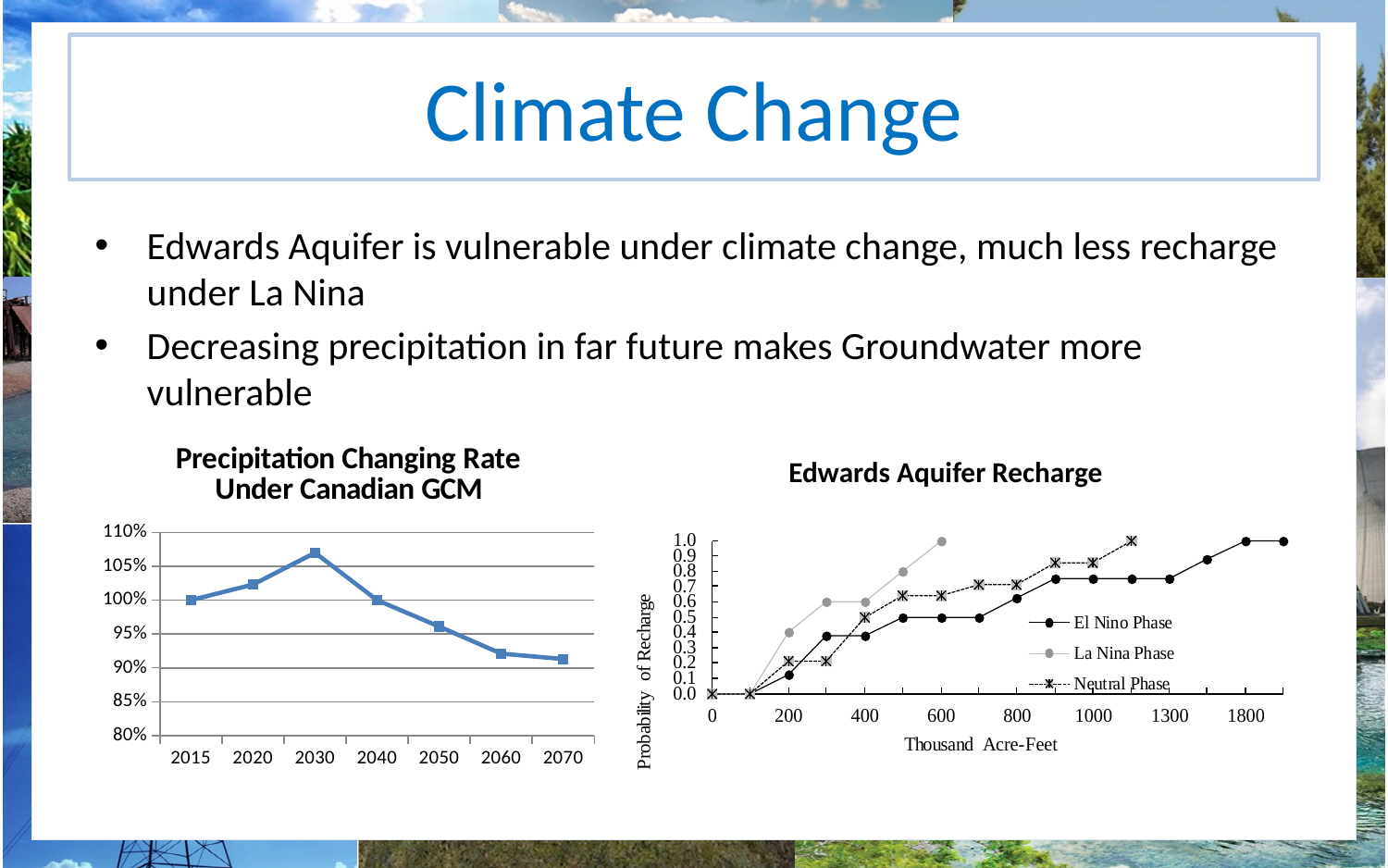
What type of chart is the 'Edwards Aquifer Recharge' chart? Line chart How many series does the legend of the 'Edwards Aquifer Recharge' chart list? 3 In the 'Precipitation Changing Rate Under Canadian GCM' chart, is the value for 2030 greater or less than 105%? greater What type of chart is the 'Precipitation Changing Rate Under Canadian GCM' chart? Line chart In the 'Precipitation Changing Rate Under Canadian GCM' chart, is the value for 2060 greater or less than 95%? less In the 'Precipitation Changing Rate Under Canadian GCM' chart, which is larger, the value for 2020 or the value for 2050? 2020 In the 'Precipitation Changing Rate Under Canadian GCM' chart, do the values rise or fall from 2030 to 2070? Fall In the 'Precipitation Changing Rate Under Canadian GCM' chart, which year has the highest value? 2030 In the 'Edwards Aquifer Recharge' chart, what is the probability of recharge for the La Nina Phase at 600 thousand acre-feet? 1.0 What is the x-axis title of the 'Edwards Aquifer Recharge' chart? Thousand Acre-Feet In the 'Precipitation Changing Rate Under Canadian GCM' chart, what is the value for 2015? 100% How many data points are plotted in the 'Precipitation Changing Rate Under Canadian GCM' chart? 7